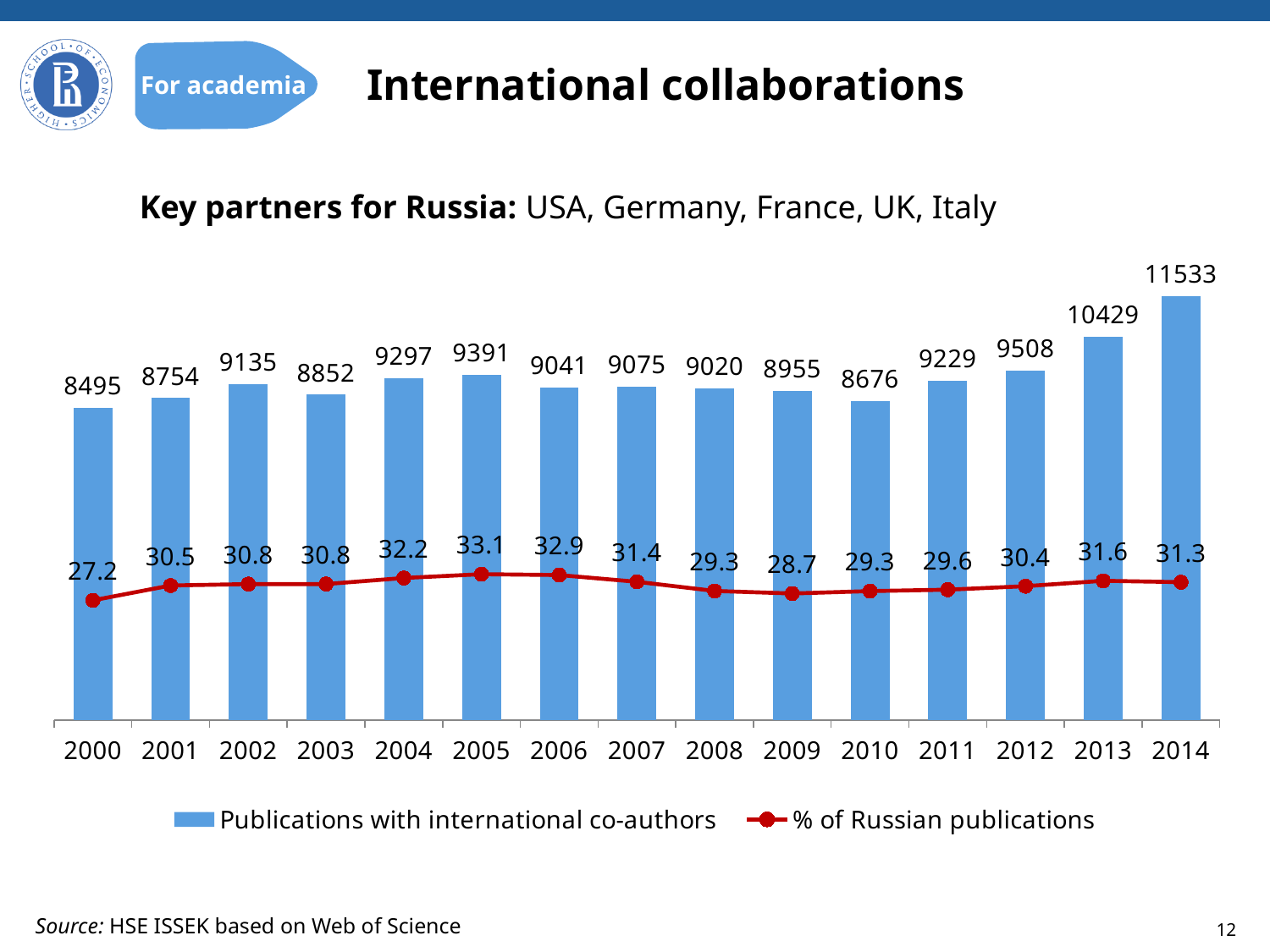
Did the number of publications with international co-authors rise or fall from 2010 to 2014? rise Which year had more publications with international co-authors, 2005 or 2006? 2005 Which year has the lowest % of Russian publications? 2000 Which year has the highest number of publications with international co-authors? 2014 What kind of chart is used for the publications with international co-authors series? bar chart What is the difference in publications with international co-authors between 2014 and 2013? 1104 What colour are the bars for publications with international co-authors? blue What was the % of Russian publications in 2005? 33.1 How many years are shown on the x axis? 15 How many series does the legend list? 2 How many publications with international co-authors were there in 2014? 11533 What was the % of Russian publications in 2009? 28.7